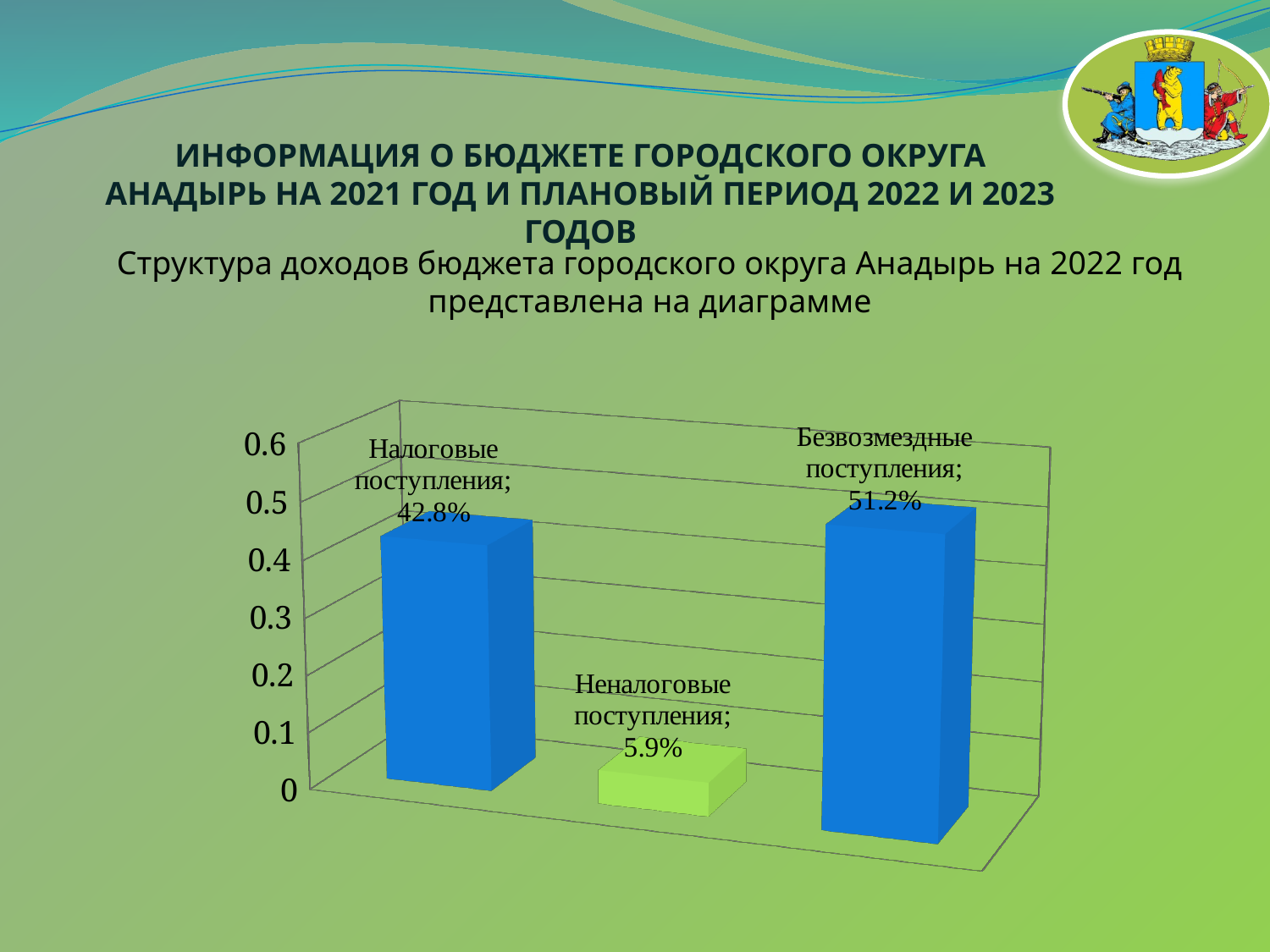
What is the value for Безвозмездные поступления? 51.2% What is the difference between Налоговые поступления and Неналоговые поступления? 36.9% Is the value for Неналоговые поступления greater or less than 0.1? less What is the highest value shown on the vertical axis? 0.6 What is the value for Неналоговые поступления? 5.9% What is the value for Налоговые поступления? 42.8% Which is larger, Налоговые поступления or Безвозмездные поступления? Безвозмездные поступления What kind of chart is shown on the slide? bar chart How many categories are shown in the chart? 3 Which category has the highest value? Безвозмездные поступления Which category has the lowest value? Неналоговые поступления What is the difference between Безвозмездные поступления and Налоговые поступления? 8.4%